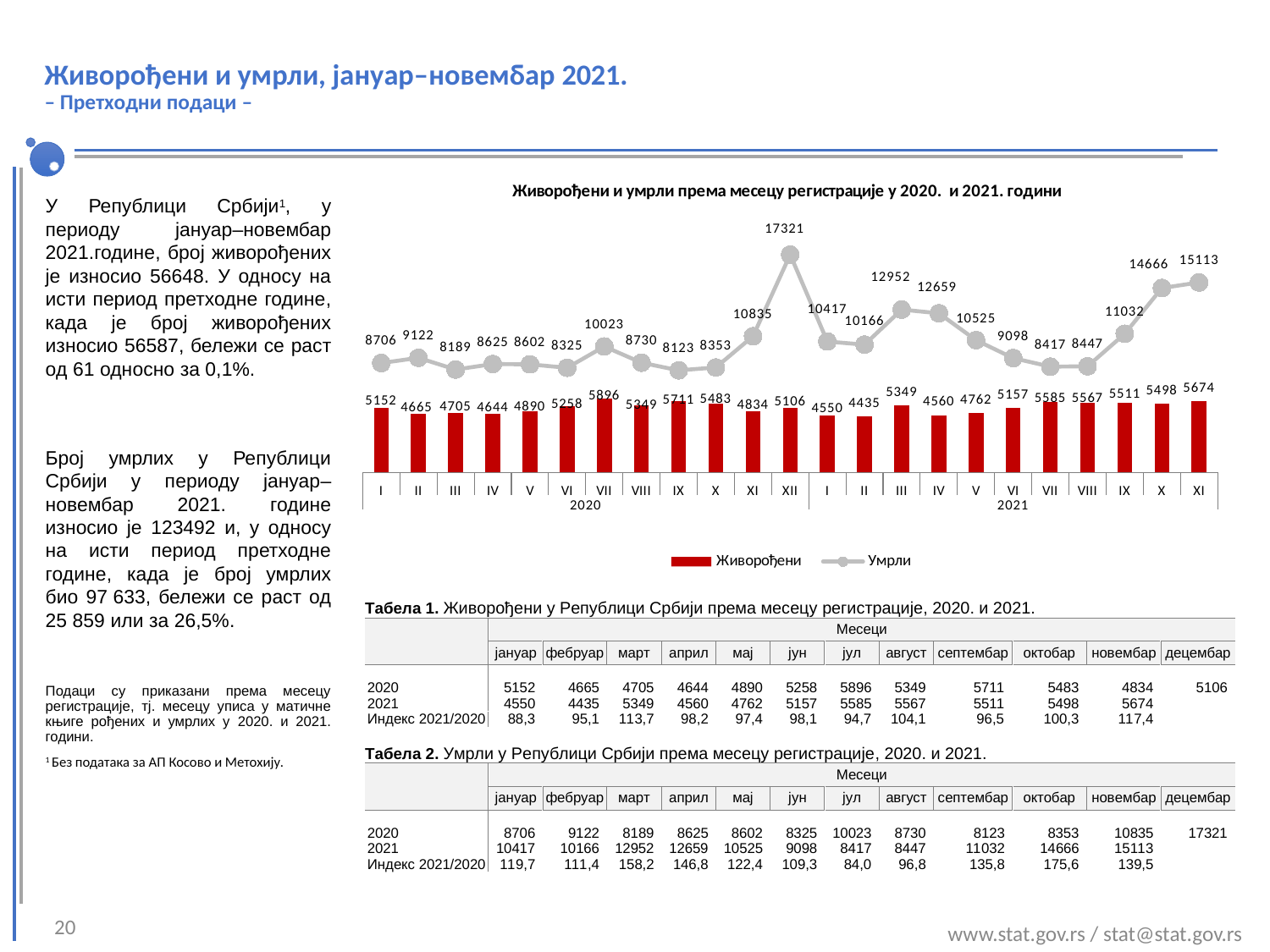
What is the value of Умрли for III 2021? 12952 Which is larger: Живорођени in III 2021 or Живорођени in III 2020? III 2021 What is the difference between Умрли in XI 2021 and Умрли in XI 2020? 4278 In which month is the Живорођени value lowest? II 2021 In which month does the Умрли series reach its highest value? XII 2020 What kind of chart is shown? Combined bar and line chart Which series is shown as red bars? Живорођени What is the value of Умрли for XII 2020? 17321 Does the Умрли series rise or fall from VIII 2021 to XI 2021? rise How many months (data points) are plotted on the x axis? 23 What is the value of Живорођени for VII 2020? 5896 How many series does the legend list? 2